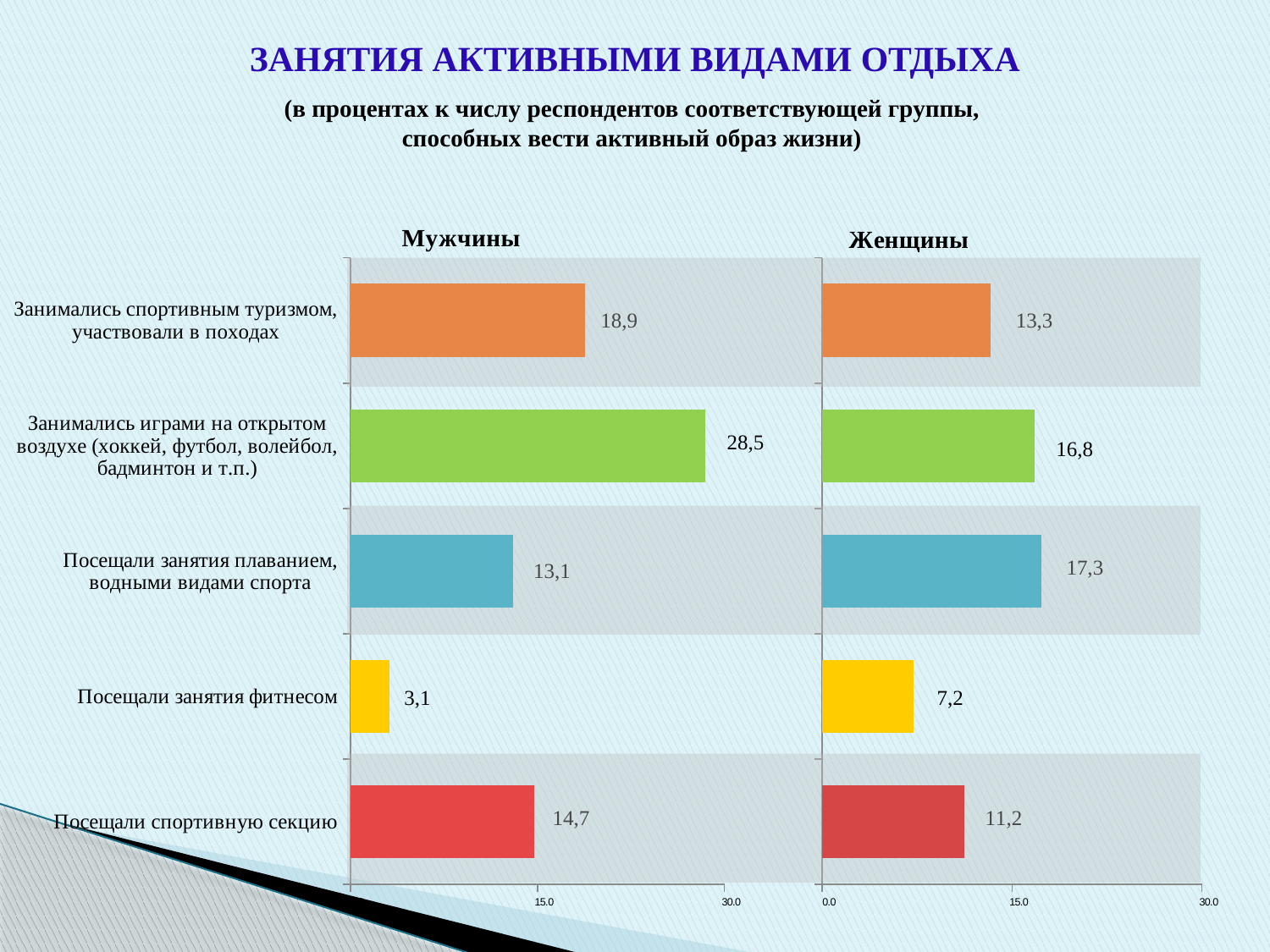
На диаграмме «Мужчины» какое значение указано для категории «Посещали занятия фитнесом»? 3,1 Каким цветом показана категория «Посещали занятия фитнесом» на обеих диаграммах? Жёлтым На сколько значение для «Посещали занятия фитнесом» на диаграмме «Женщины» больше, чем на диаграмме «Мужчины»? 4,1 Какое значение для «Посещали спортивную секцию» больше: на диаграмме «Мужчины» или на диаграмме «Женщины»? Мужчины На диаграмме «Женщины» какое значение указано для категории «Посещали занятия плаванием, водными видами спорта»? 17,3 На диаграмме «Женщины» значение для «Занимались играми на открытом воздухе» больше или меньше 15,0? больше На диаграмме «Мужчины» на сколько значение для «Занимались играми на открытом воздухе» больше значения для «Занимались спортивным туризмом, участвовали в походах»? 9,6 На диаграмме «Мужчины» какое значение указано для категории «Посещали спортивную секцию»? 14,7 На диаграмме «Мужчины» какая категория имеет наибольшее значение? Занимались играми на открытом воздухе (хоккей, футбол, волейбол, бадминтон и т.п.) На диаграмме «Женщины» какая категория имеет наименьшее значение? Посещали занятия фитнесом Сколько категорий показано на диаграмме «Мужчины»? 5 Какого типа диаграмма «Женщины»? Столбчатая (линейчатая) диаграмма